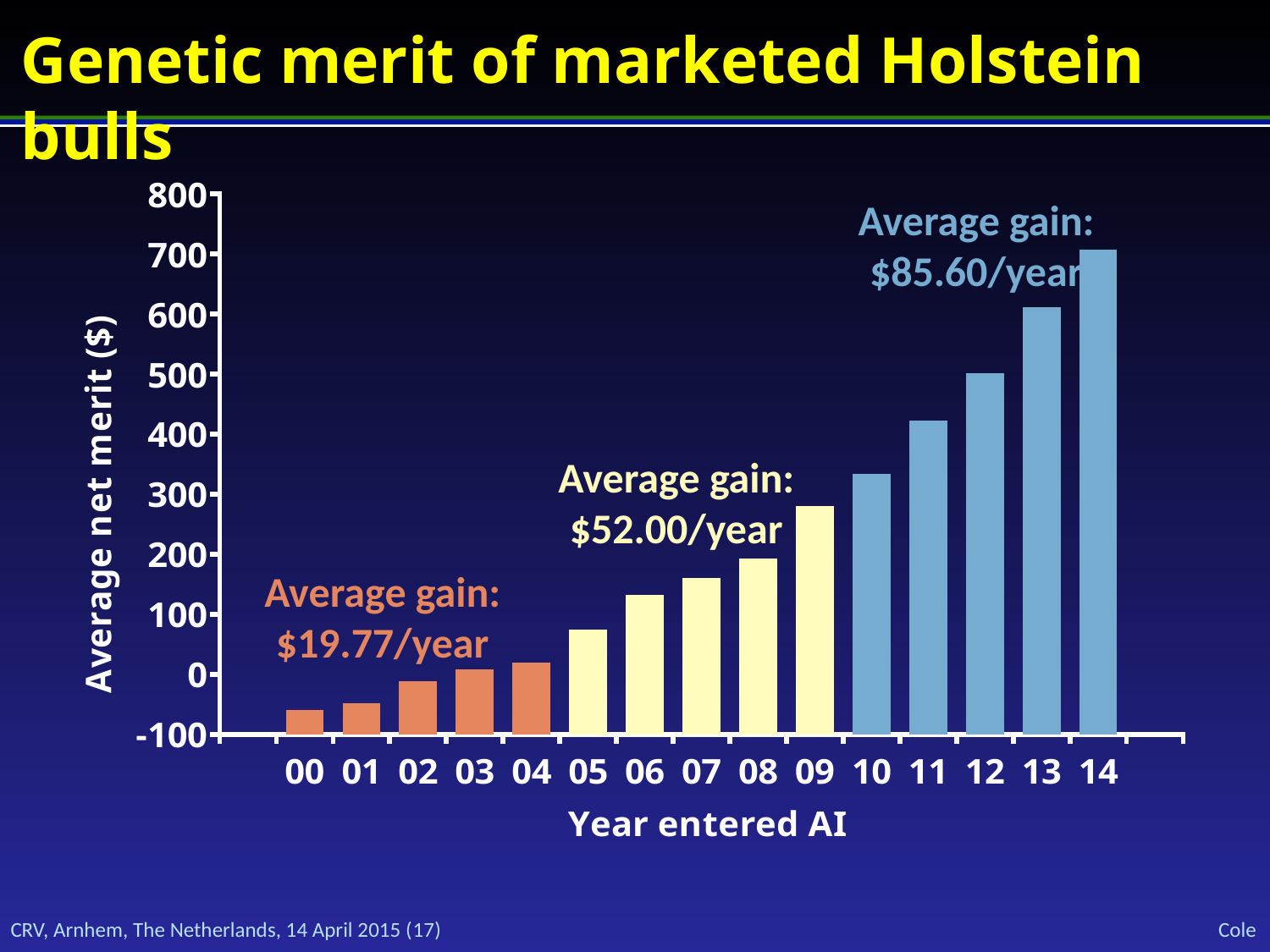
Is the average net merit for year 00 greater or less than 0? less Which has a higher average net merit, year 05 or year 10? 10 Is the average net merit for year 14 greater or less than 600? greater What average gain per year is annotated for the blue bars (years 10 to 14)? $85.60/year Which year entered AI has the lowest average net merit? 00 Is the average net merit for year 11 greater or less than 400? greater What is the label of the y axis? Average net merit ($) What kind of chart is shown on the slide? bar chart Which year entered AI has the highest average net merit? 14 Do the average net merit values rise or fall from year 00 to year 14? rise How many years (bars) are plotted on the x axis? 15